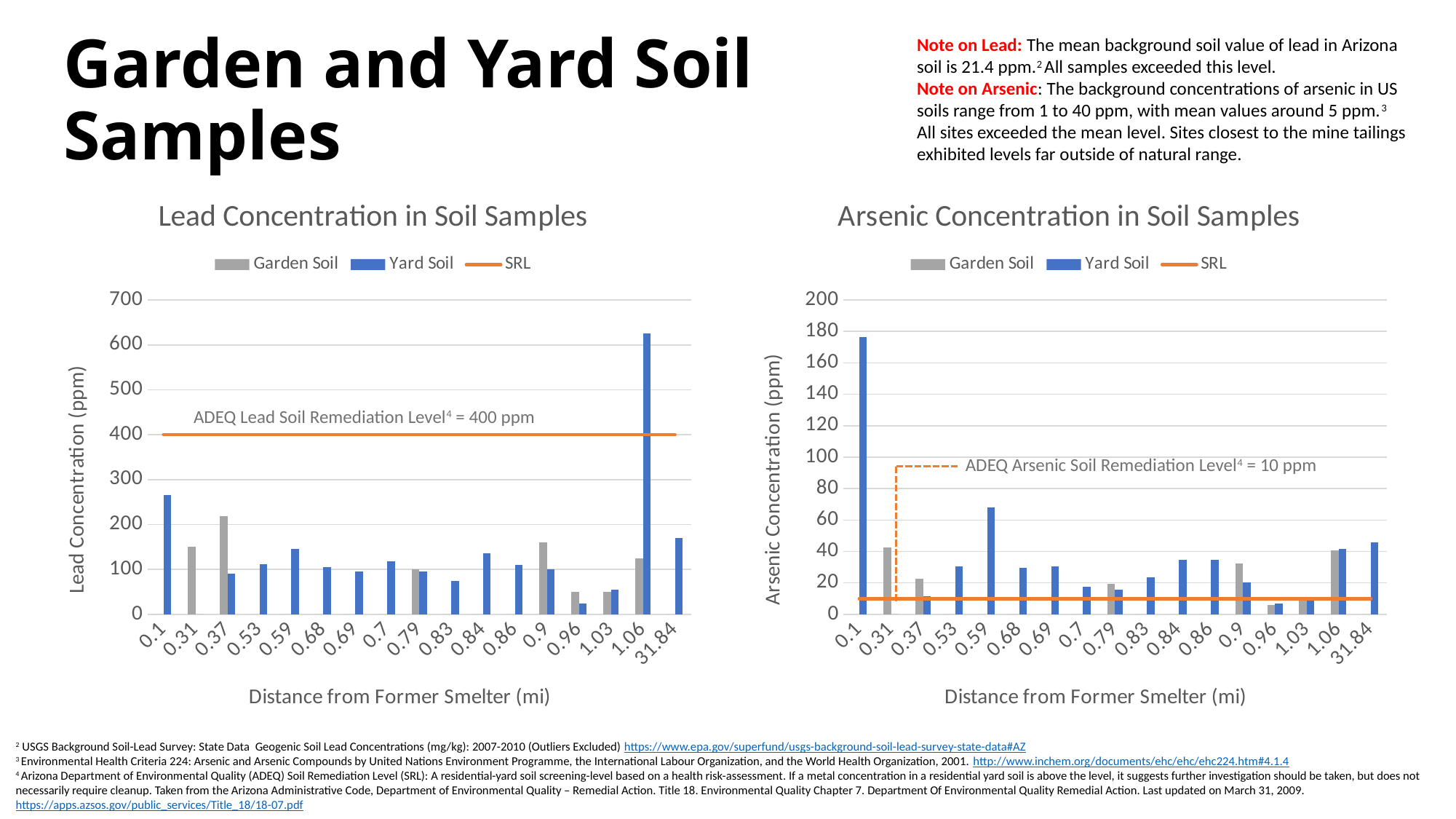
In the Lead Concentration in Soil Samples chart, which is larger: the Yard Soil value at 0.1 mi or at 0.37 mi? 0.1 mi In the Lead Concentration in Soil Samples chart, what is the ADEQ Lead Soil Remediation Level shown by the SRL line? 400 ppm In the Lead Concentration in Soil Samples chart, is the Yard Soil value at 0.1 mi greater or less than 200? greater In the Lead Concentration in Soil Samples chart, is the Yard Soil value at 1.06 mi greater or less than 600? greater In the Arsenic Concentration in Soil Samples chart, at which distance is the Yard Soil bar highest? 0.1 In the Arsenic Concentration in Soil Samples chart, what is the ADEQ Arsenic Soil Remediation Level shown by the SRL line? 10 ppm How many distance categories are shown on the x axis of the Lead Concentration in Soil Samples chart? 17 How many series does the legend of the Arsenic Concentration in Soil Samples chart list? 3 In the Arsenic Concentration in Soil Samples chart, is the Yard Soil value at 0.59 mi greater or less than 60? greater What is the x-axis title of the Lead Concentration in Soil Samples chart? Distance from Former Smelter (mi) In the Lead Concentration in Soil Samples chart, at which distance is the Yard Soil bar highest? 1.06